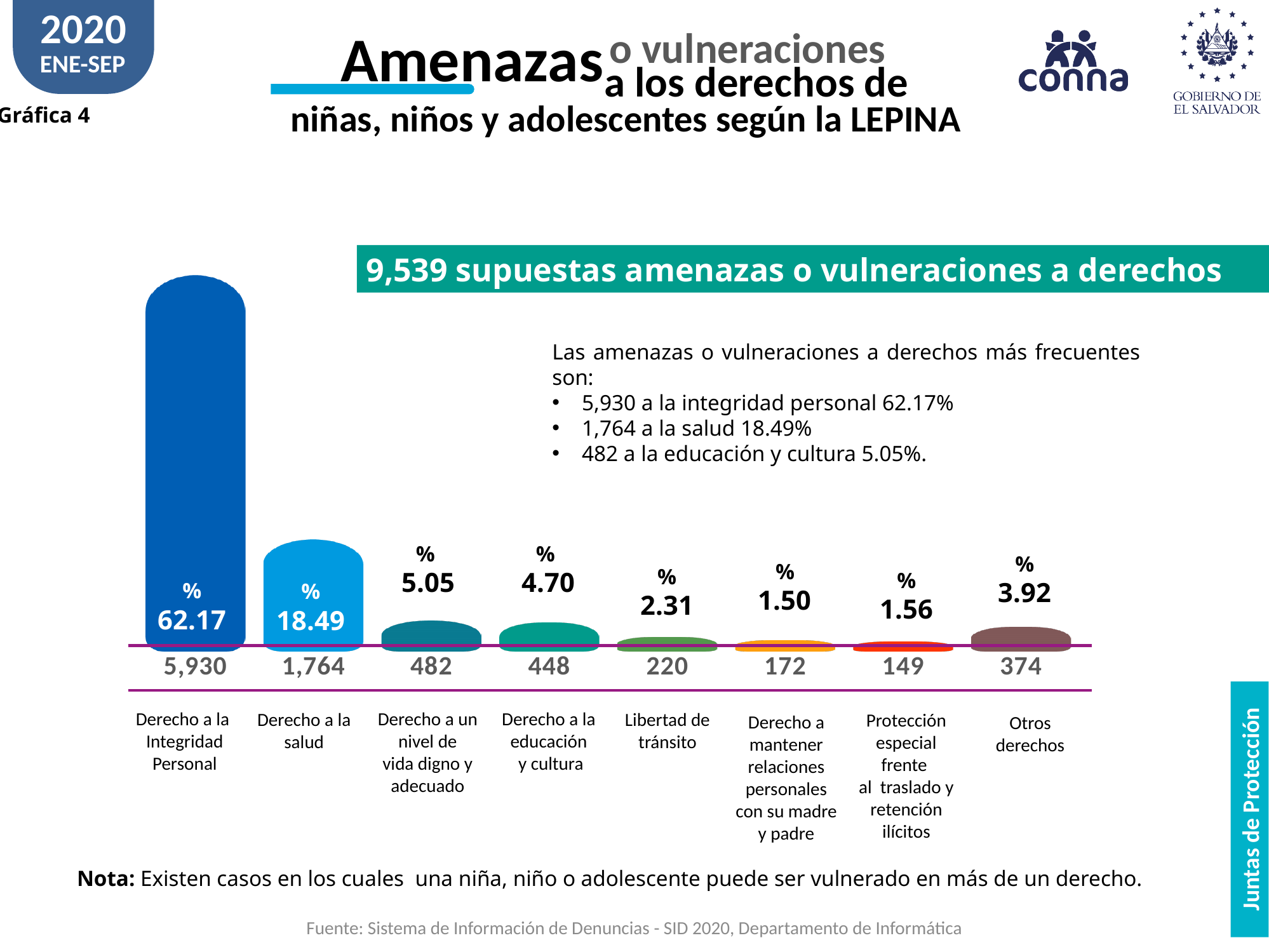
Which has more cases: Derecho a un nivel de vida digno y adecuado or Derecho a la educación y cultura? Derecho a un nivel de vida digno y adecuado What is the number of cases for Libertad de tránsito? 220 What percentage is shown for Derecho a la salud? 18.49 How many categories are shown in the chart? 8 What percentage is shown for Otros derechos? 3.92 What is the difference in cases between Derecho a la Integridad Personal and Derecho a la salud? 4,166 What kind of chart is this? Bar chart What is the total number of supposed threats or violations of rights stated on the slide? 9,539 What is the number of cases for Derecho a la Integridad Personal? 5,930 Which category has the highest number of cases? Derecho a la Integridad Personal Which category has the lowest number of cases? Protección especial frente al traslado y retención ilícitos What is the difference in cases between Otros derechos and Derecho a mantener relaciones personales con su madre y padre? 202